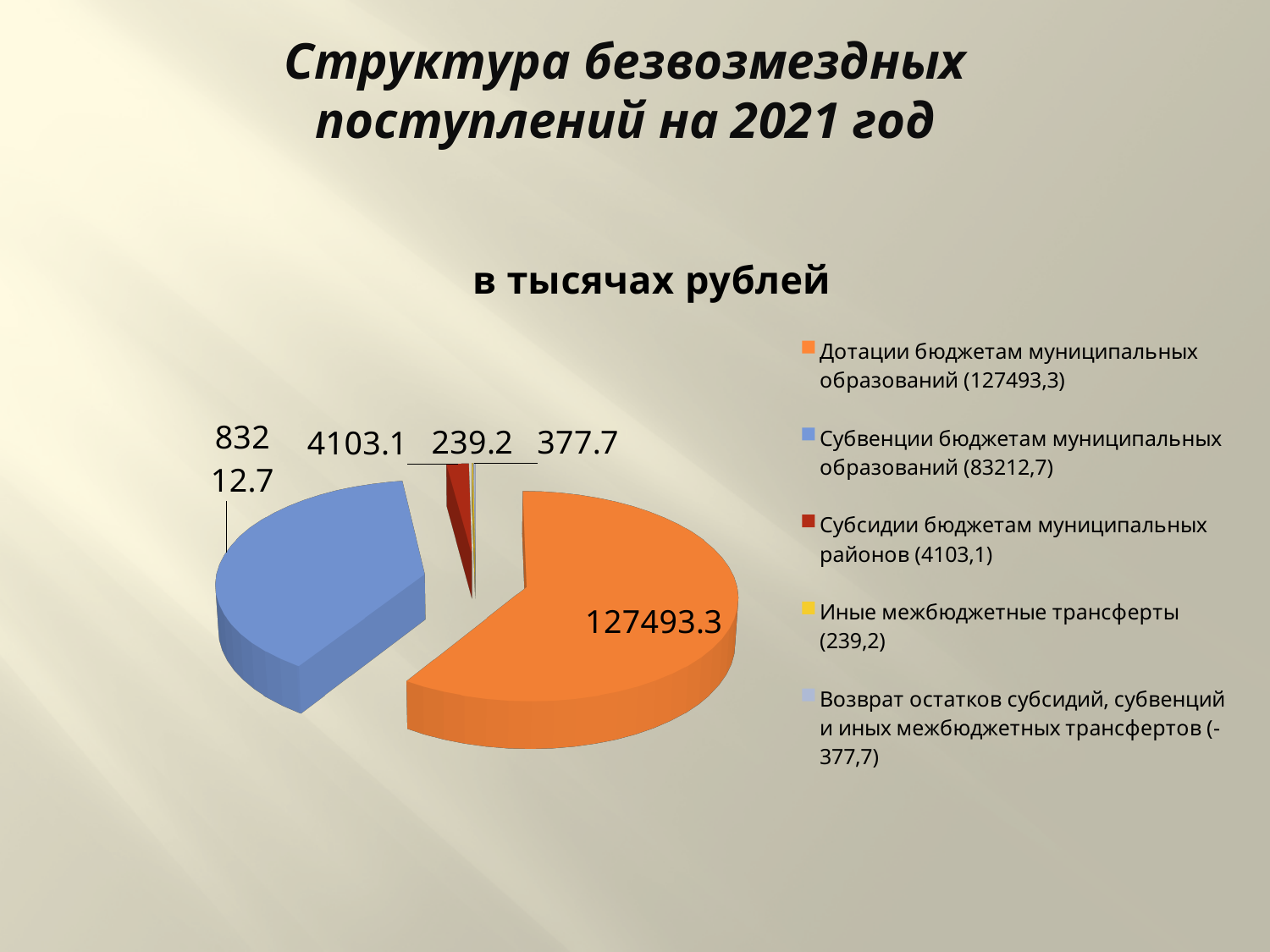
What is the value shown for Иные межбюджетные трансферты? 239.2 How many entries does the legend list? 5 What is the value shown for Дотации бюджетам муниципальных образований? 127493.3 Which is larger: Субсидии бюджетам муниципальных районов or Иные межбюджетные трансферты? Субсидии бюджетам муниципальных районов What value does the legend give for Субвенции бюджетам муниципальных образований? 83212,7 What is the value shown for Субсидии бюджетам муниципальных районов? 4103.1 What is the difference between the values for Субсидии бюджетам муниципальных районов and Иные межбюджетные трансферты? 3863.9 What type of chart is shown on the slide? pie chart Which category has the largest slice of the pie? Дотации бюджетам муниципальных образований What colour is the slice for Субвенции бюджетам муниципальных образований? blue What is the title of the chart? в тысячах рублей How many categories does the pie chart have? 5